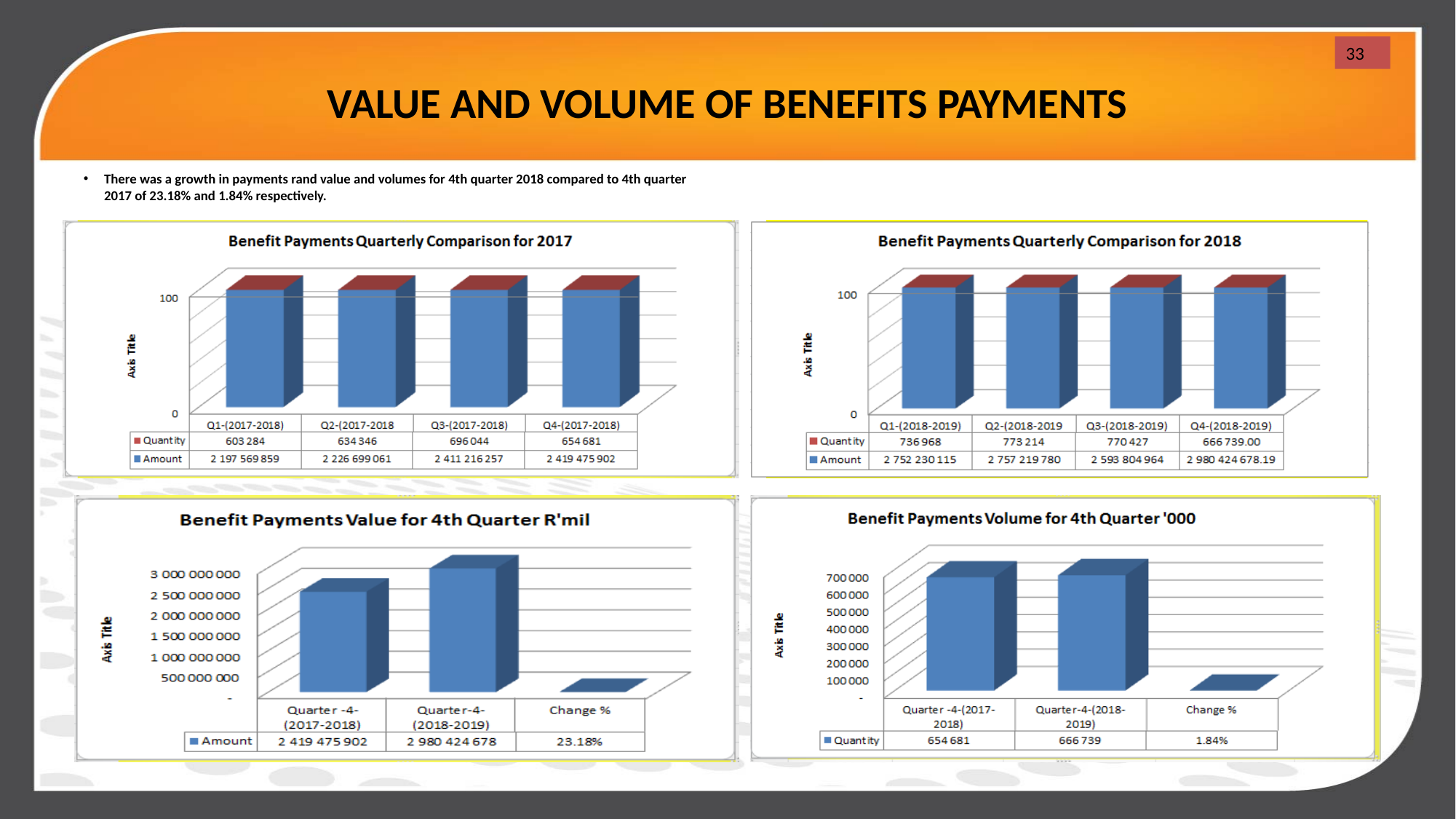
In the 'Benefit Payments Quarterly Comparison for 2017' chart, what is the Quantity for Q3-(2017-2018)? 696 044 In the 'Benefit Payments Volume for 4th Quarter '000' chart, which is larger, the Quantity for Quarter-4-(2017-2018) or Quarter-4-(2018-2019)? Quarter-4-(2018-2019) In the 'Benefit Payments Quarterly Comparison for 2018' chart, which quarter has the lowest Amount? Q3-(2018-2019) In the 'Benefit Payments Quarterly Comparison for 2017' chart, which quarter has the lowest Quantity? Q1-(2017-2018) In the 'Benefit Payments Quarterly Comparison for 2017' chart, what is the Amount for Q1-(2017-2018)? 2 197 569 859 In the 'Benefit Payments Value for 4th Quarter R'mil' chart, what is the Change %? 23.18% In the 'Benefit Payments Quarterly Comparison for 2018' chart, how many series does the legend list? 2 In the 'Benefit Payments Quarterly Comparison for 2018' chart, what is the Amount for Q3-(2018-2019)? 2 593 804 964 In the 'Benefit Payments Quarterly Comparison for 2018' chart, which quarter has the highest Quantity? Q2-(2018-2019) In the 'Benefit Payments Volume for 4th Quarter '000' chart, what is the difference in Quantity between Quarter-4-(2018-2019) and Quarter-4-(2017-2018)? 12 058 In the 'Benefit Payments Value for 4th Quarter R'mil' chart, what is the difference in Amount between Quarter-4-(2018-2019) and Quarter-4-(2017-2018)? 560 948 776 What kind of chart is the 'Benefit Payments Volume for 4th Quarter '000' chart? Bar chart